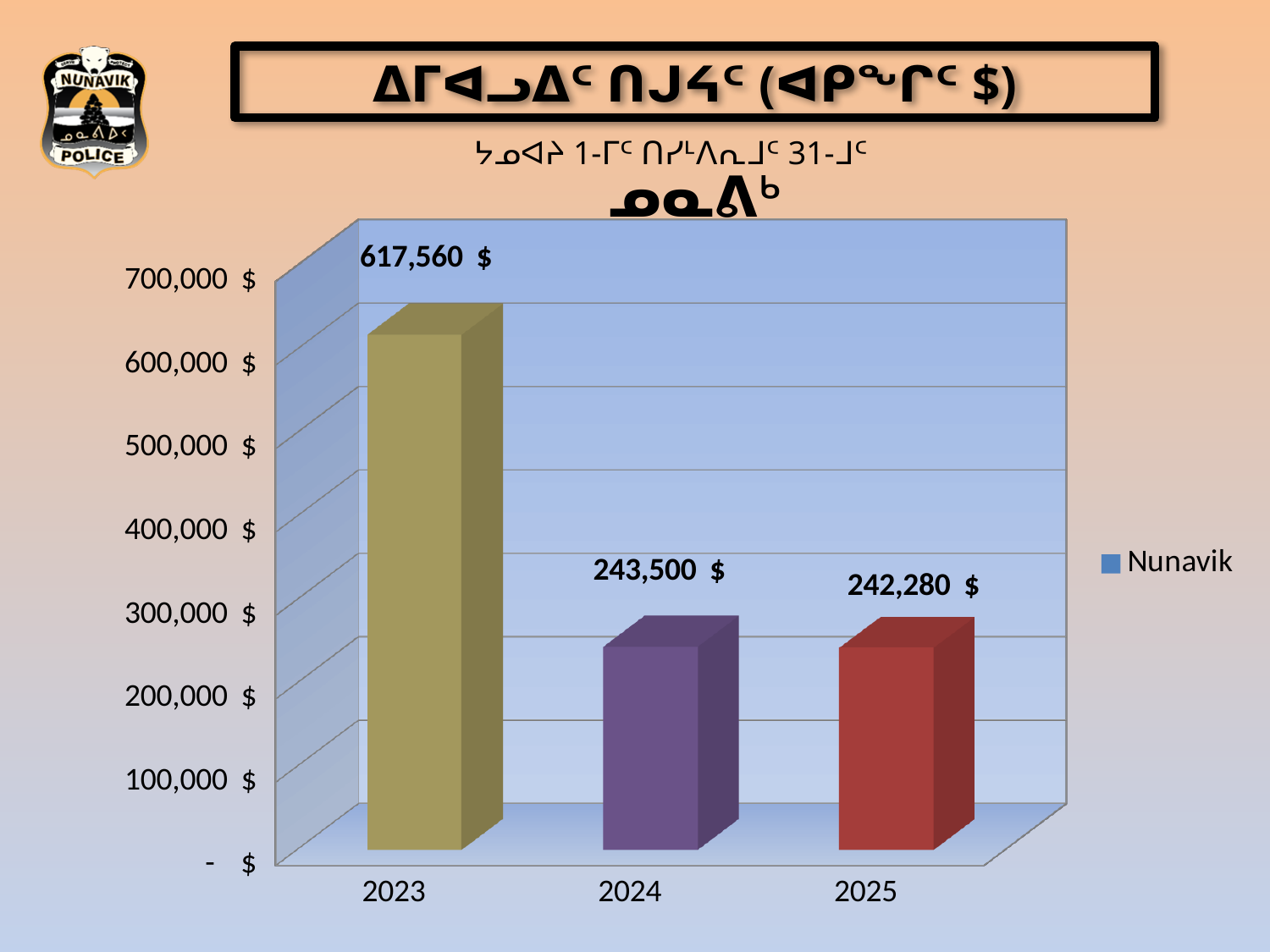
Which year has the highest value? 2023 Which year has the lowest value according to the data labels? 2025 Is the value for 2024 greater or less than 300,000 $? less How many series does the legend list? 1 What is the value for 2023? 617,560 $ How many years are shown on the x axis? 3 What is the value for 2024? 243,500 $ Which is larger, the value for 2023 or the value for 2025? 2023 What is the difference between the values for 2024 and 2025? 1,220 $ What is the value for 2025? 242,280 $ What is the difference between the values for 2023 and 2024? 374,060 $ What kind of chart is shown? bar chart